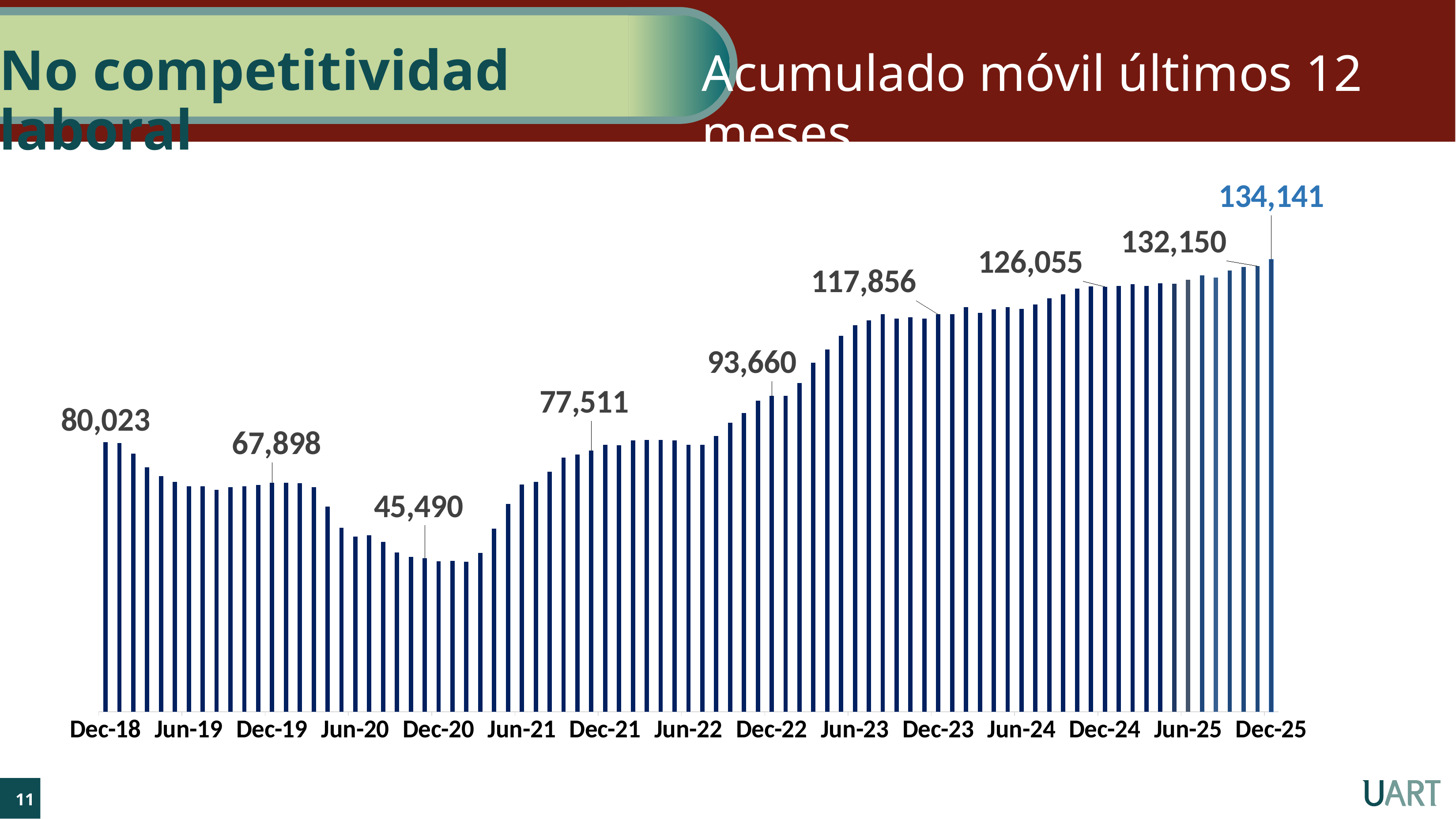
Which of the labelled values on the chart is the highest? 134,141 What is the value labelled at Dec-23? 117,856 What is the value labelled at Dec-22? 93,660 What is the value shown for Dec-18? 80,023 What is the value shown for the last bar, Dec-25? 134,141 Do the values rise or fall from Dec-20 to Dec-25? rise Which is larger, the value for Dec-19 or the value for Dec-21? Dec-21 Which of the labelled values on the chart is the lowest? 45,490 What is the difference between the Dec-25 value and the Dec-18 value? 54,118 What kind of chart is shown on the slide? bar chart